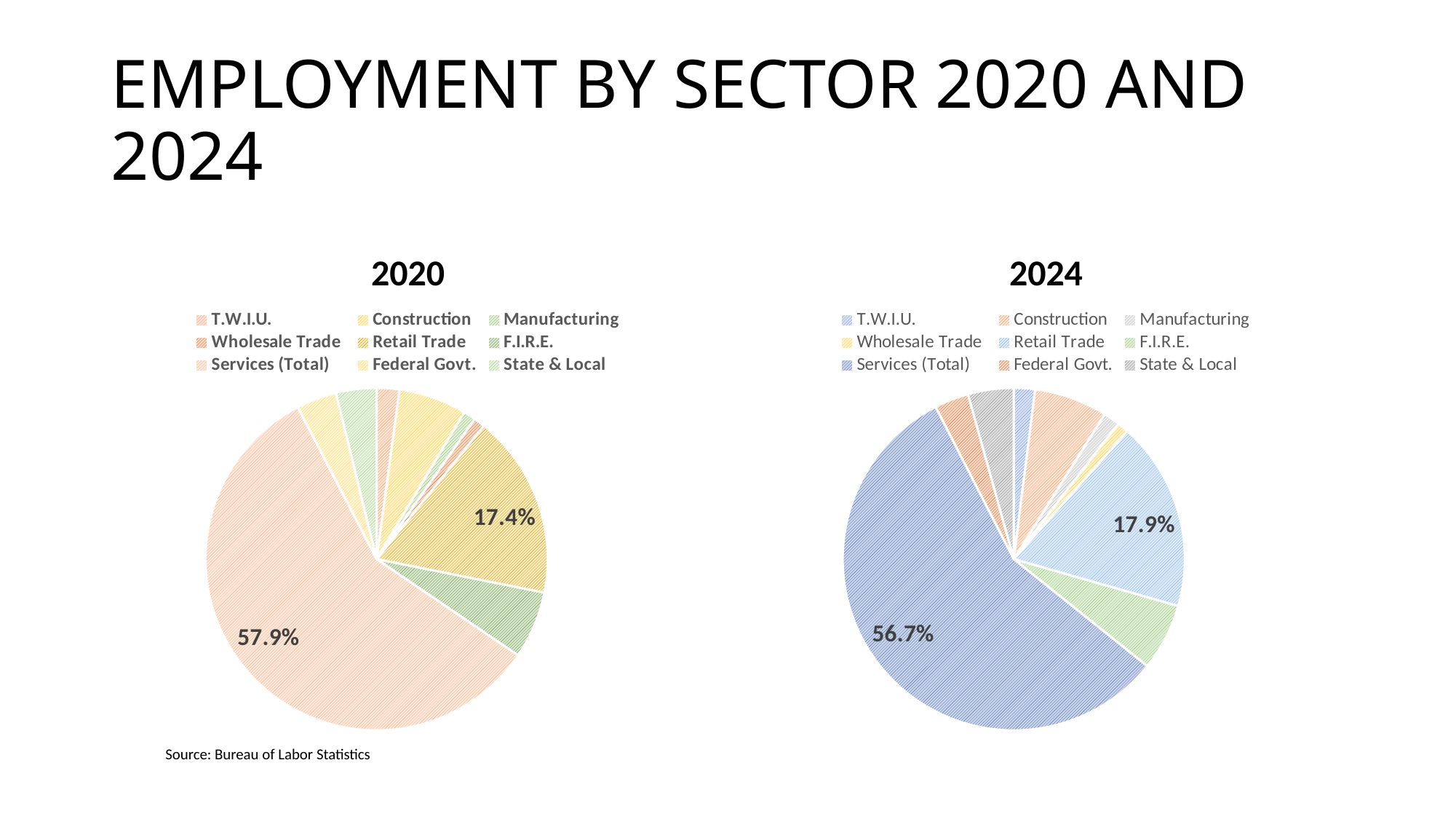
In the 2020 chart, what percentage is shown for the largest slice? 57.9% Is the Retail Trade share larger in the 2020 chart or the 2024 chart? 2024 In the 2020 chart, what is the difference in percentage points between the 57.9% slice and the 17.4% slice? 40.5 In the 2024 chart, which sector has the largest slice? Services (Total) In the 2024 chart, what share is labelled on the Retail Trade slice? 17.9% What source is cited below the charts? Bureau of Labor Statistics How many sectors are listed in the legend of the 2024 chart? 9 In the 2020 chart, which sector has the largest slice? Services (Total) What type of chart is used for the 2020 chart? Pie chart In the 2024 chart, what percentage is shown for the largest slice? 56.7% In the 2020 chart, what share is labelled on the Retail Trade slice? 17.4% Is the Services (Total) share larger in the 2020 chart or the 2024 chart? 2020